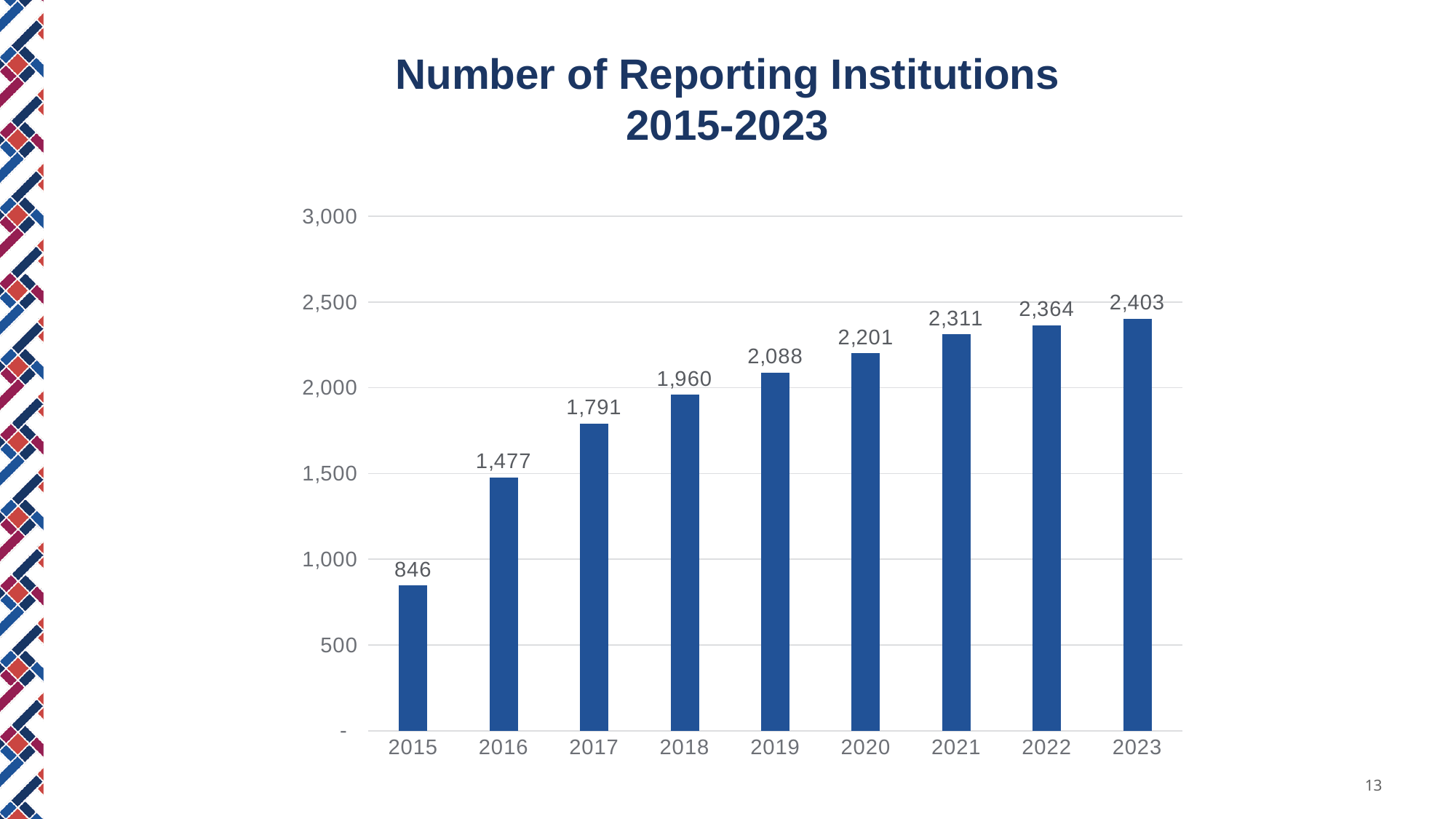
Is the value for 2021 greater or less than 2,000? greater Do the values rise or fall from 2015 to 2023? Rise How many years are shown on the x axis? 9 Which year has the highest number of reporting institutions? 2023 What kind of chart is shown on the slide? Bar chart Which year has the lowest number of reporting institutions? 2015 Which year has more reporting institutions, 2018 or 2020? 2020 What is the difference between the number of reporting institutions in 2017 and in 2016? 314 What is the number of reporting institutions in 2015? 846 What is the number of reporting institutions in 2023? 2,403 What is the number of reporting institutions in 2019? 2,088 What is the difference between the number of reporting institutions in 2023 and in 2015? 1,557